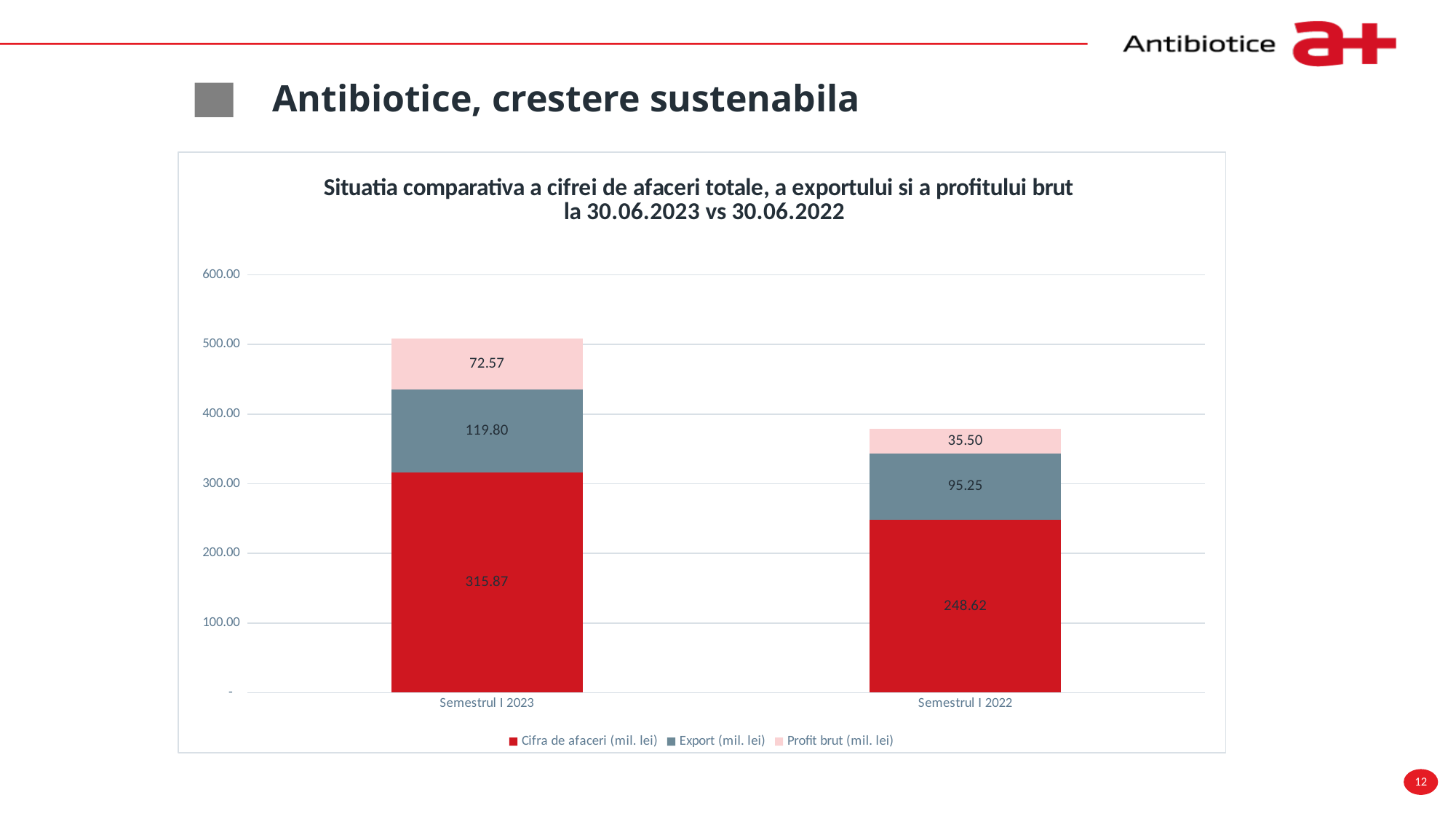
Is the Export (mil. lei) value larger for Semestrul I 2023 or Semestrul I 2022? Semestrul I 2023 What is the value of Cifra de afaceri (mil. lei) for Semestrul I 2023? 315.87 What is the difference in Cifra de afaceri (mil. lei) between Semestrul I 2023 and Semestrul I 2022? 67.25 Which period has the higher Cifra de afaceri (mil. lei)? Semestrul I 2023 What is the total of the stacked bar for Semestrul I 2023? 508.24 What is the value of Profit brut (mil. lei) for Semestrul I 2023? 72.57 What is the value of Profit brut (mil. lei) for Semestrul I 2022? 35.50 What is the total of the stacked bar for Semestrul I 2022? 379.37 What is the difference in Export (mil. lei) between Semestrul I 2023 and Semestrul I 2022? 24.55 What is the value of Export (mil. lei) for Semestrul I 2022? 95.25 How many series does the legend list? 3 What kind of chart is shown on the slide? Stacked bar chart